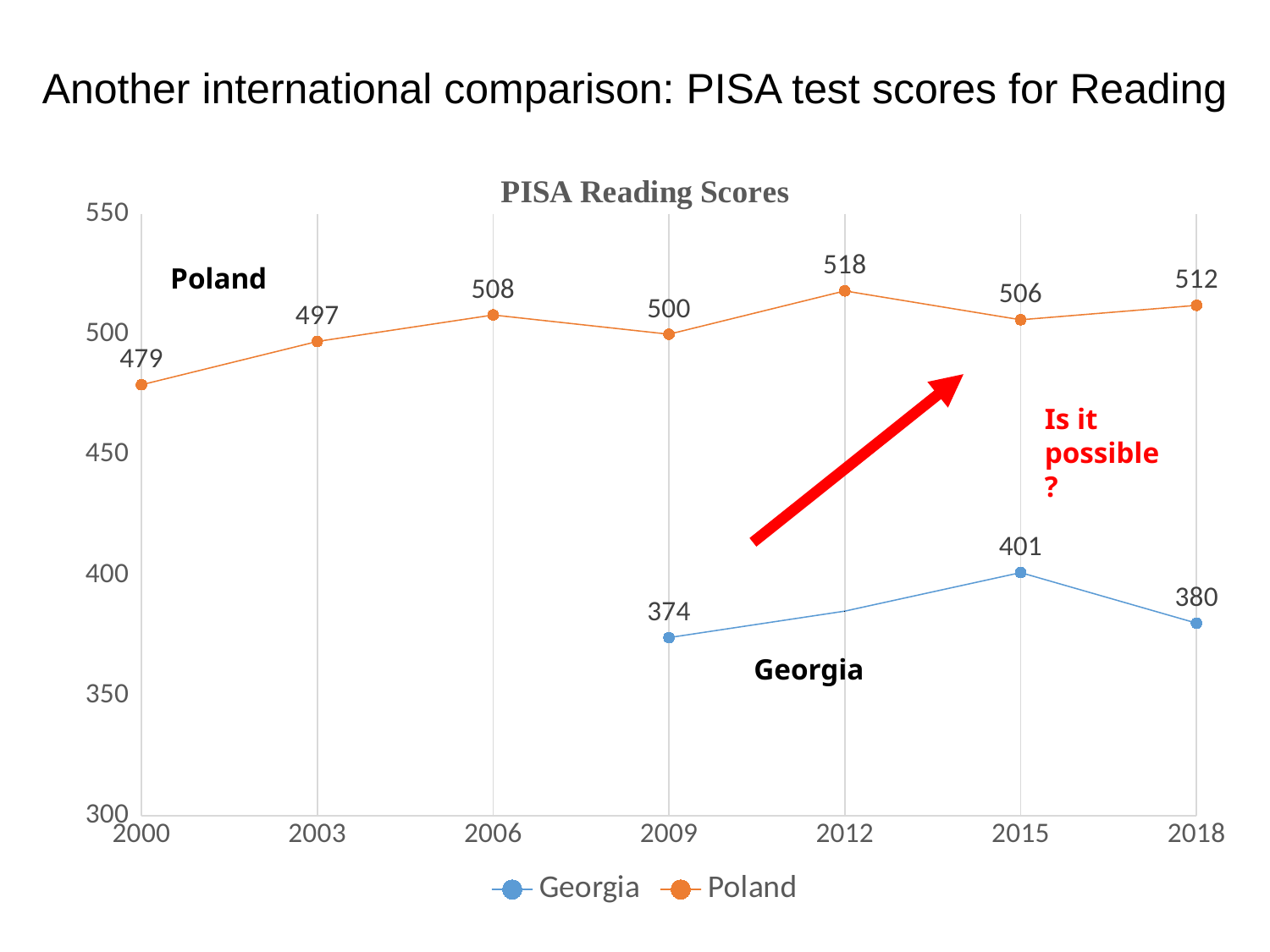
What is Poland's PISA reading score in 2012? 518 What is Georgia's PISA reading score in 2018? 380 What is the difference between Poland's and Georgia's scores in 2015? 105 In which year does Poland have its lowest PISA reading score? 2000 What kind of chart is shown on the slide? line chart Which country has the higher score in 2018? Poland In which year does Poland have its highest PISA reading score? 2012 By how much did Georgia's score change from 2015 to 2018? 21 What is Georgia's PISA reading score in 2009? 374 How many years are shown on the x axis? 7 Is Georgia's score in 2015 greater or less than 450? less How many series does the legend list? 2